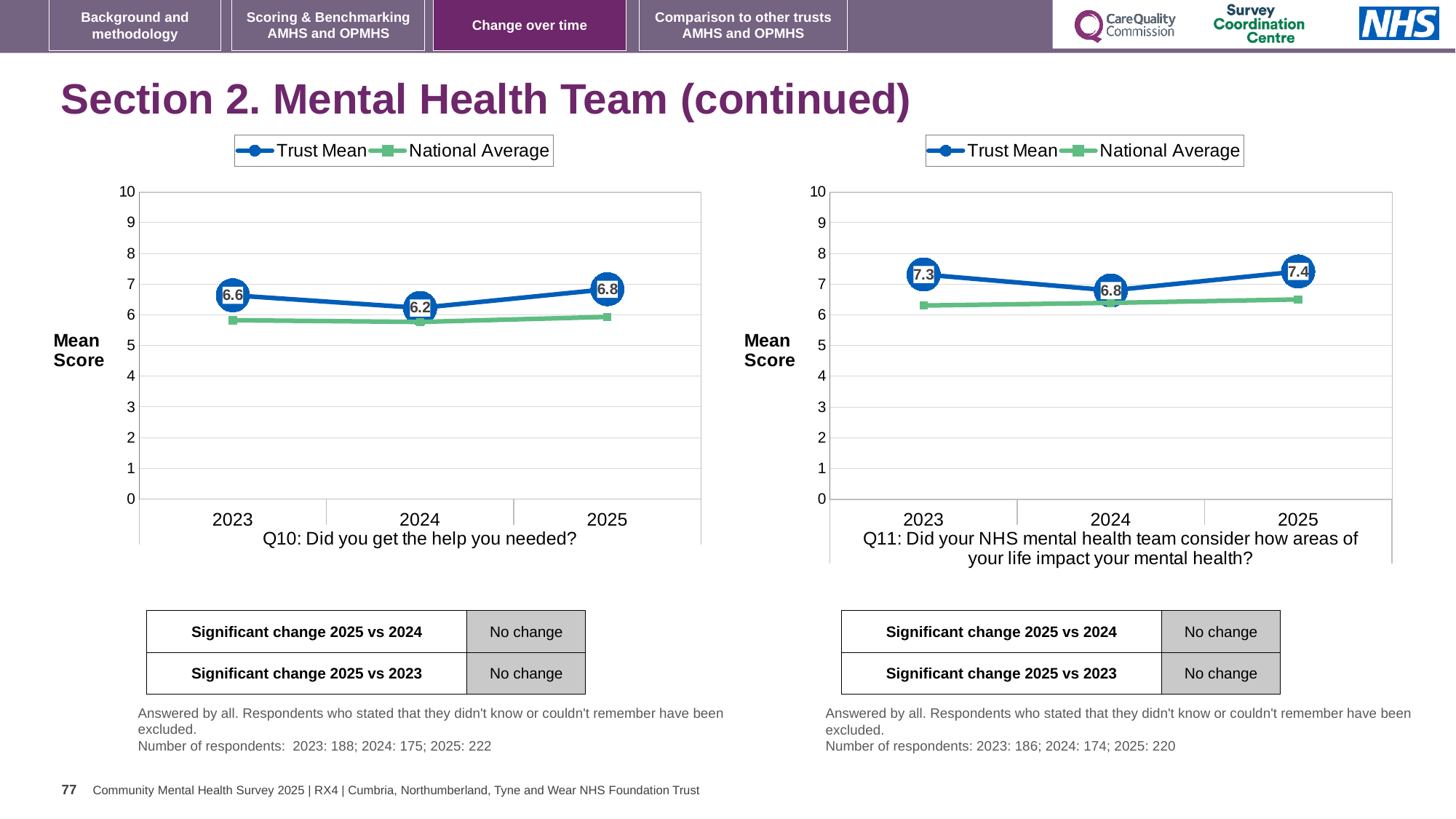
How many series does the legend of the Q11 chart (right) list? 2 On the Q11 chart (right), which year has the lowest Trust Mean score? 2024 On the Q11 chart (right), which is larger in 2023: the Trust Mean or the National Average? Trust Mean On the Q10 chart (left), what is the Trust Mean score for 2024? 6.2 On the Q11 chart (right), what is the Trust Mean score for 2025? 7.4 On the Q10 chart (left), is the National Average value for 2023 greater or less than 7? less On the Q10 chart (left), what is the difference between the Trust Mean scores for 2025 and 2024? 0.6 On the Q10 chart (left), which year has the highest Trust Mean score? 2025 What kind of chart is the Q10 chart (left)? Line chart On the Q11 chart (right), does the Trust Mean rise or fall from 2024 to 2025? Rise On the Q11 chart (right), what is the difference between the Trust Mean scores for 2023 and 2024? 0.5 How many years are plotted on the x axis of the Q10 chart (left)? 3